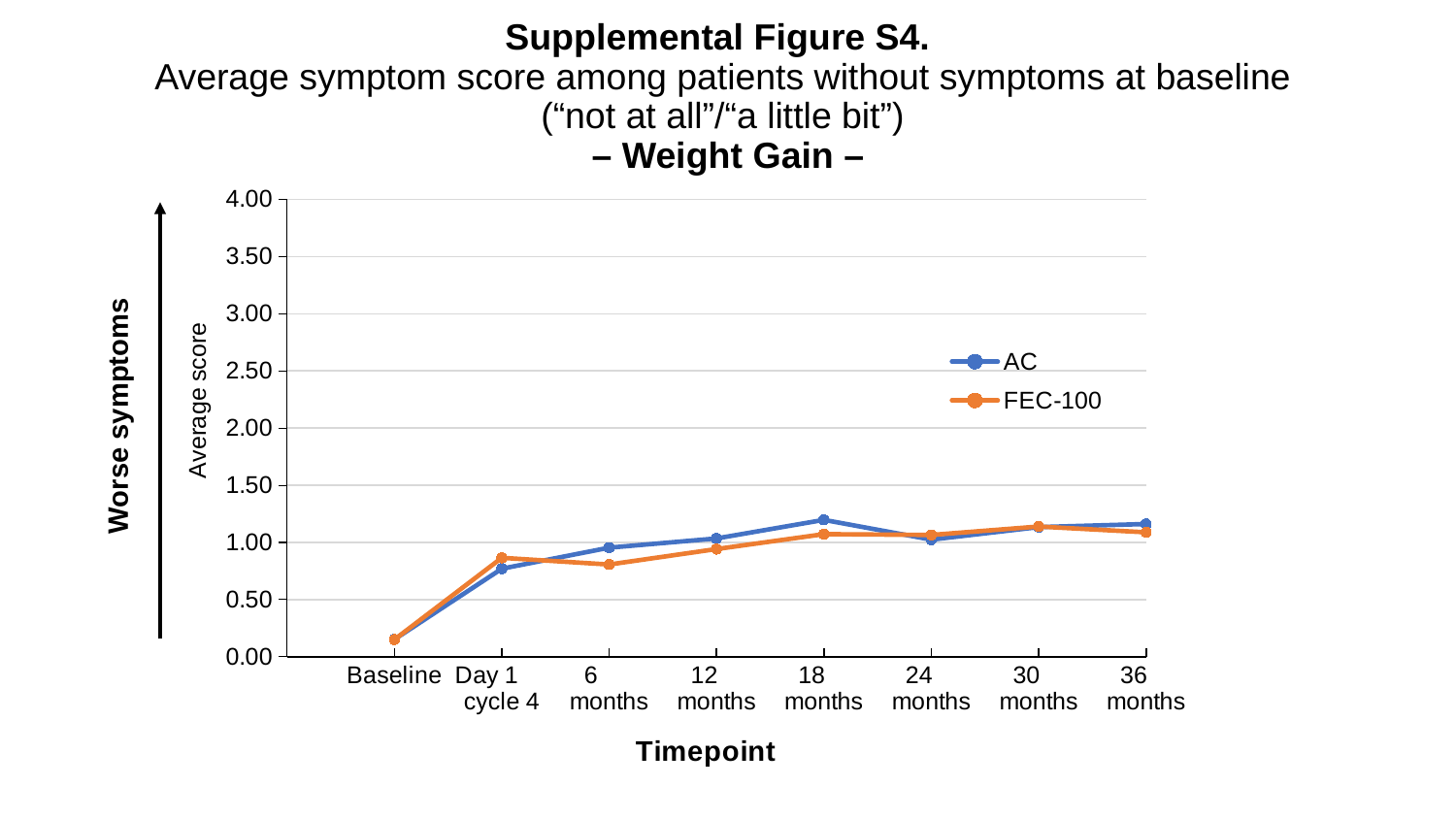
Is the value for FEC-100 at Baseline greater or less than 0.50? less What kind of chart is shown on the slide? Line chart At 6 months, which series has the higher average score, AC or FEC-100? AC Is the value for FEC-100 at 6 months greater or less than 1.00? less At which timepoint is the FEC-100 series lowest? Baseline How many timepoints are plotted along the x axis? 8 How many series does the legend list? 2 At which timepoint is the AC series lowest? Baseline Do the average scores generally rise or fall from Baseline to 36 months? Rise At Day 1 cycle 4, which series has the higher average score, AC or FEC-100? FEC-100 Is the value for AC at 36 months greater or less than 1.50? less